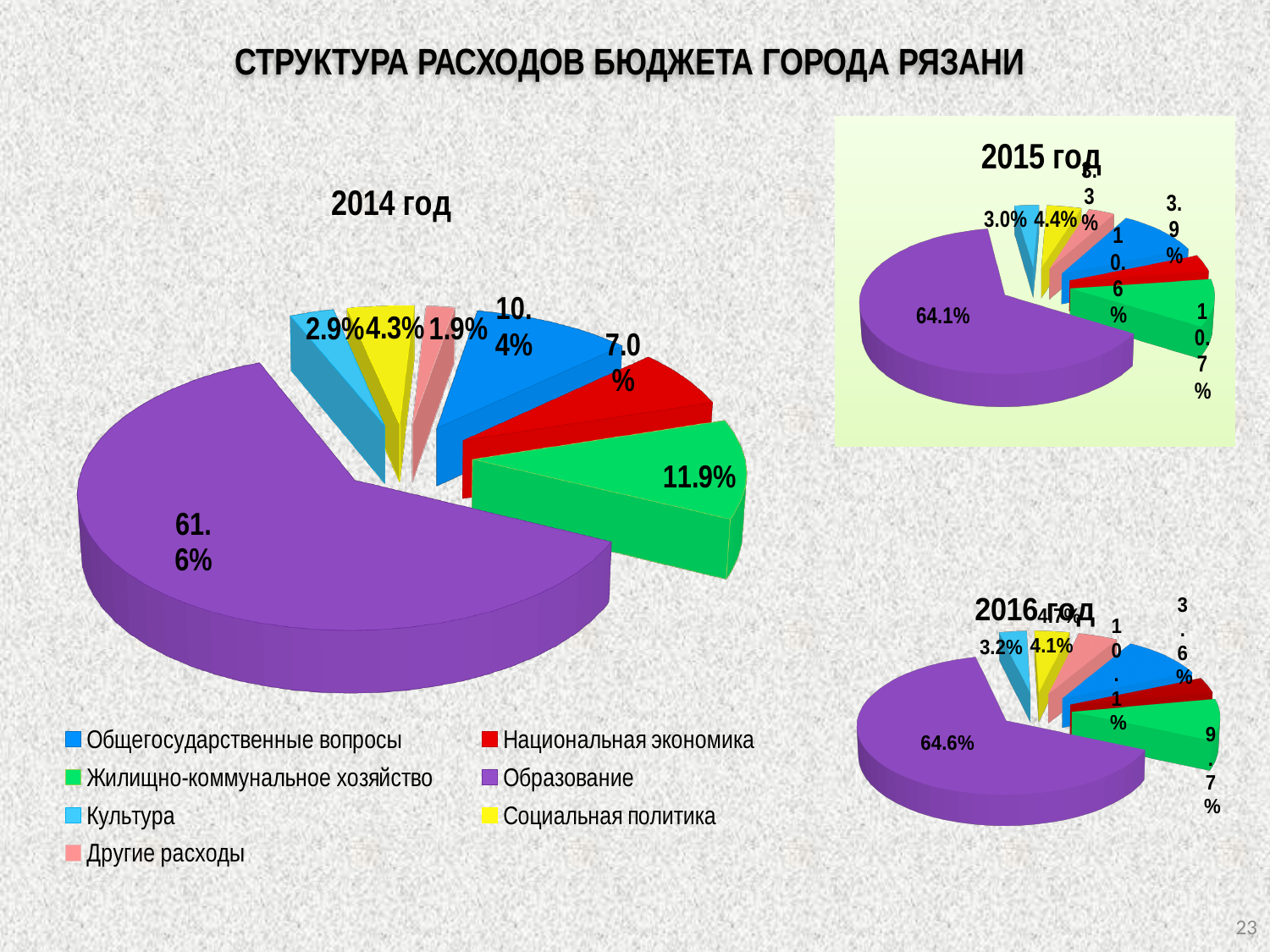
In the 2015 год chart, what share does Образование have? 64.1% In the 2014 год chart, what is the value for Жилищно-коммунальное хозяйство? 11.9% In the 2014 год chart, what share of the budget goes to Образование? 61.6% In the 2016 год chart, what share does Образование have? 64.6% In the 2014 год chart, what is the difference between Общегосударственные вопросы and Национальная экономика? 3.4% How many categories does the legend list? 7 In the 2016 год chart, what is the value for Жилищно-коммунальное хозяйство? 9.7% In the 2015 год chart, which is larger: Культура or Социальная политика? Социальная политика What type of chart is used for the 2014 год data? Pie chart In the 2014 год chart, which category has the smallest share? Другие расходы In the 2014 год chart, what is the value for Национальная экономика? 7.0% In the 2015 год chart, what is the value for Социальная политика? 4.4%